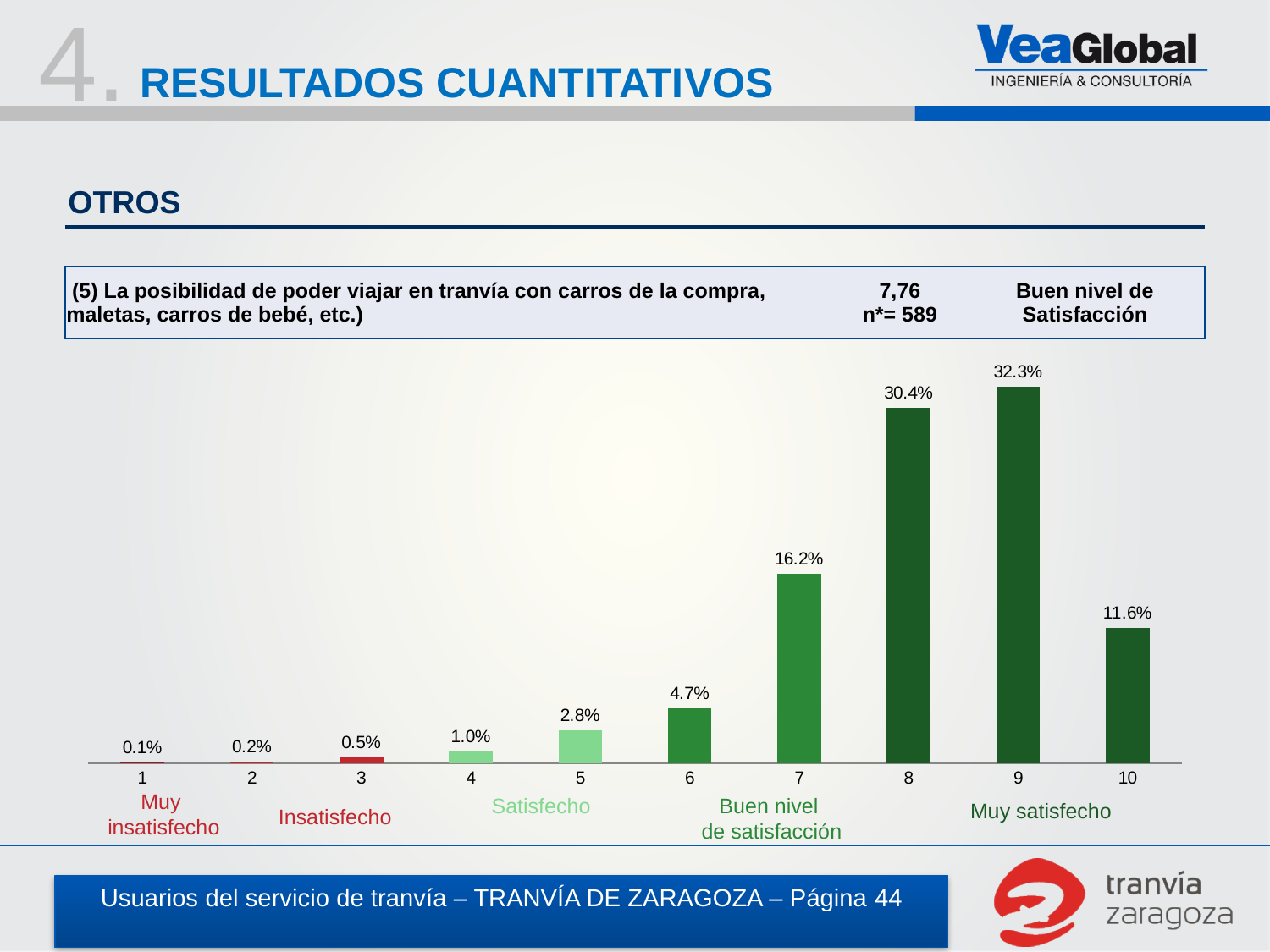
Do the values generally rise or fall from category 1 to category 9? Rise What kind of chart is shown? Bar chart What is the difference between the values for categories 7 and 10? 4.6% What is the value for category 4? 1.0% Which category has the lowest value? 1 What is the value for category 7? 16.2% What is the mean score shown in the box above the chart? 7,76 What is the value for category 9? 32.3% How many categories are shown on the x axis? 10 Which is larger, the value for category 6 or the value for category 10? 10 What is the difference between the values for categories 9 and 8? 1.9% Which category has the highest value? 9